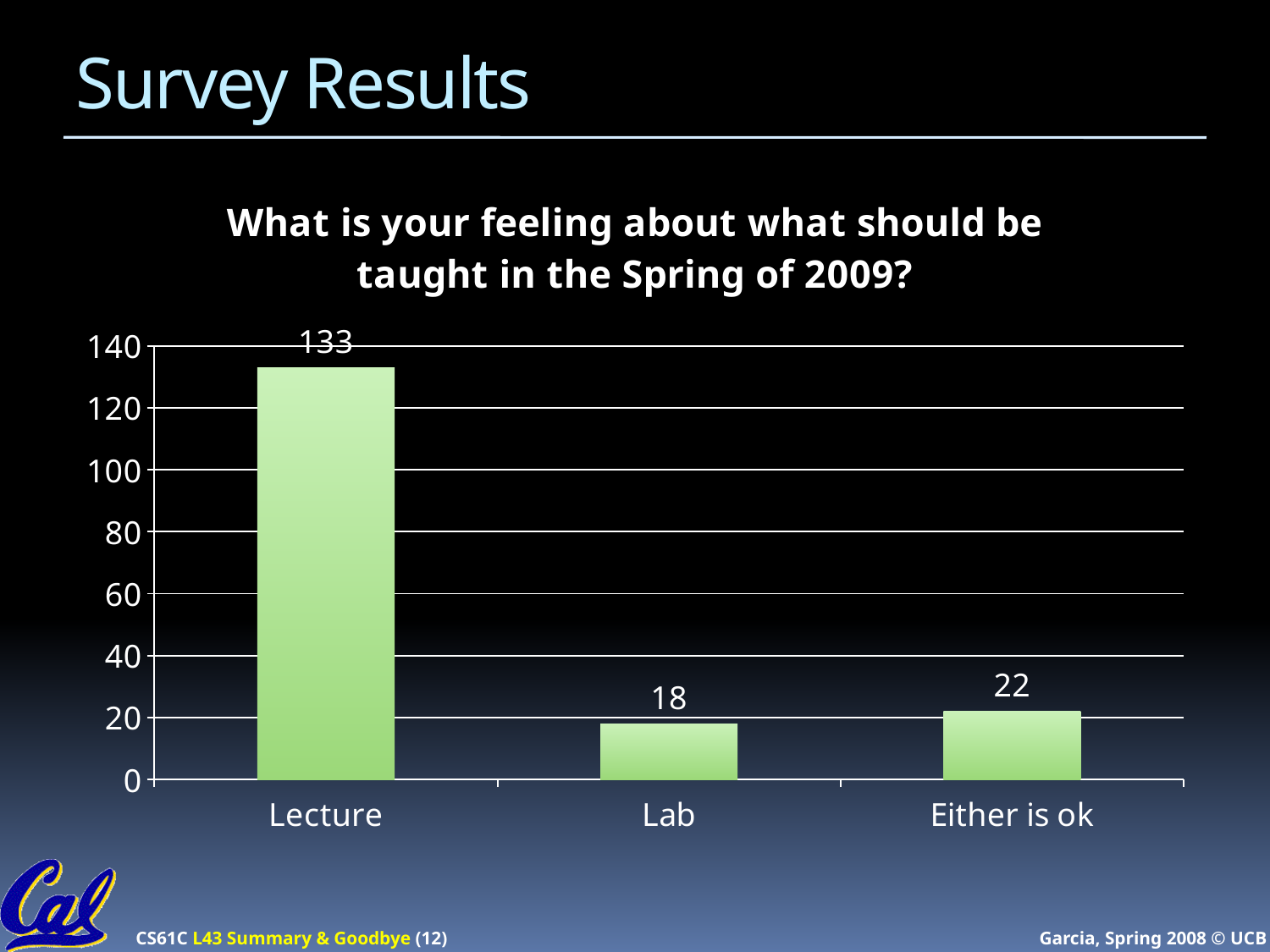
Which category has the highest value? Lecture What is the title of the chart? What is your feeling about what should be taught in the Spring of 2009? What kind of chart is shown on the slide? bar chart How many categories are shown on the x axis? 3 Which category has the lowest value? Lab What is the difference between the values for Lecture and Lab? 115 Is the value for Lecture greater or less than 120? greater What is the value for Either is ok? 22 Which is larger, the value for Lab or the value for Either is ok? Either is ok What is the value for Lab? 18 What is the difference between the values for Either is ok and Lab? 4 What is the value for Lecture? 133